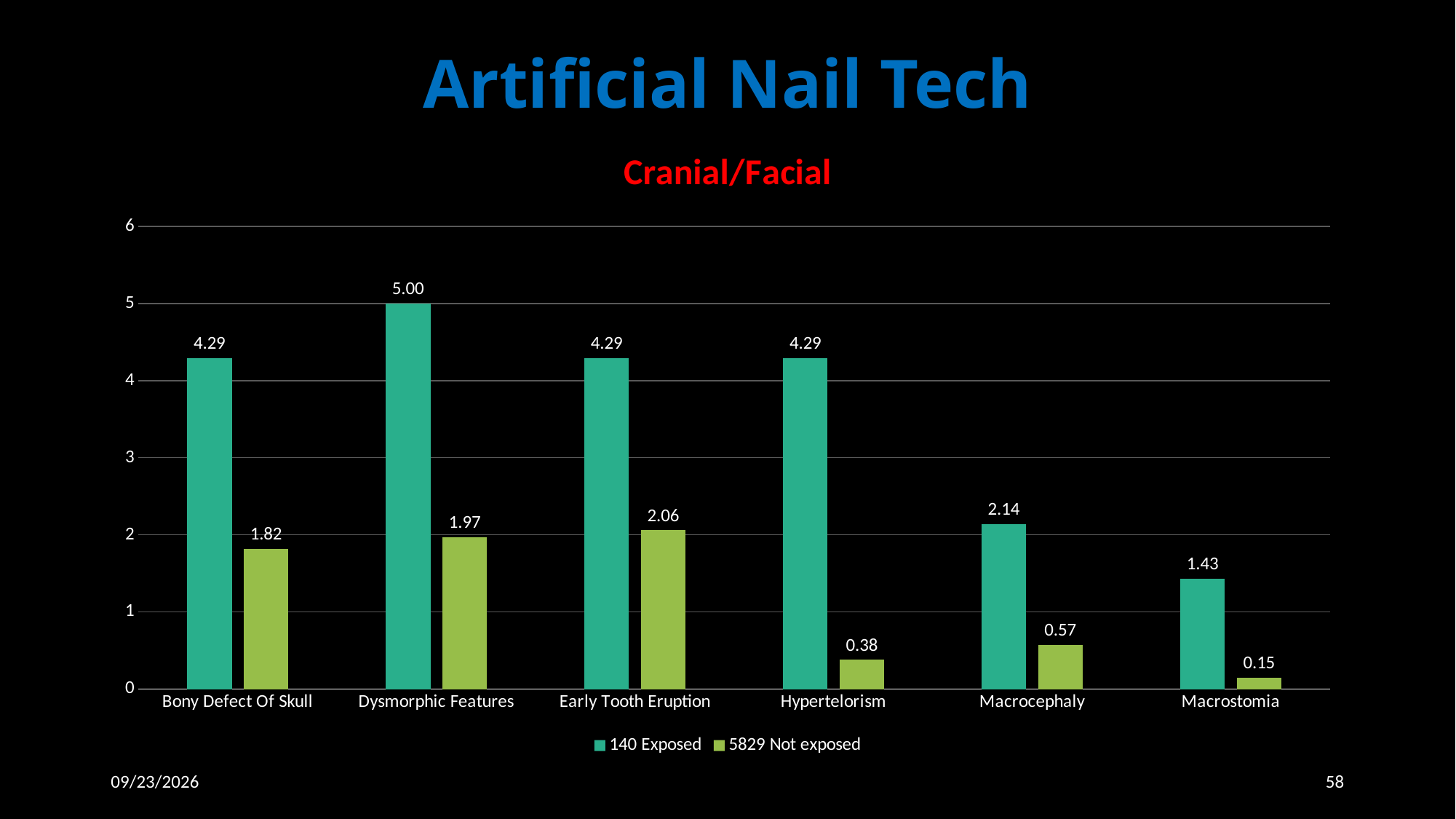
What kind of chart is shown on the slide? bar chart How many series does the legend list? 2 Which category has the highest value for 140 Exposed? Dysmorphic Features How many categories are shown on the x axis? 6 What is the value for 5829 Not exposed for Hypertelorism? 0.38 What is the title of the chart? Cranial/Facial Is the value for 140 Exposed for Macrostomia greater or less than 2? less What is the value for 140 Exposed for Dysmorphic Features? 5.00 What is the value for 5829 Not exposed for Macrostomia? 0.15 Which category has the lowest value for 5829 Not exposed? Macrostomia Which is larger: the 5829 Not exposed value for Early Tooth Eruption or for Dysmorphic Features? Early Tooth Eruption What is the difference between the 140 Exposed and 5829 Not exposed values for Macrocephaly? 1.57